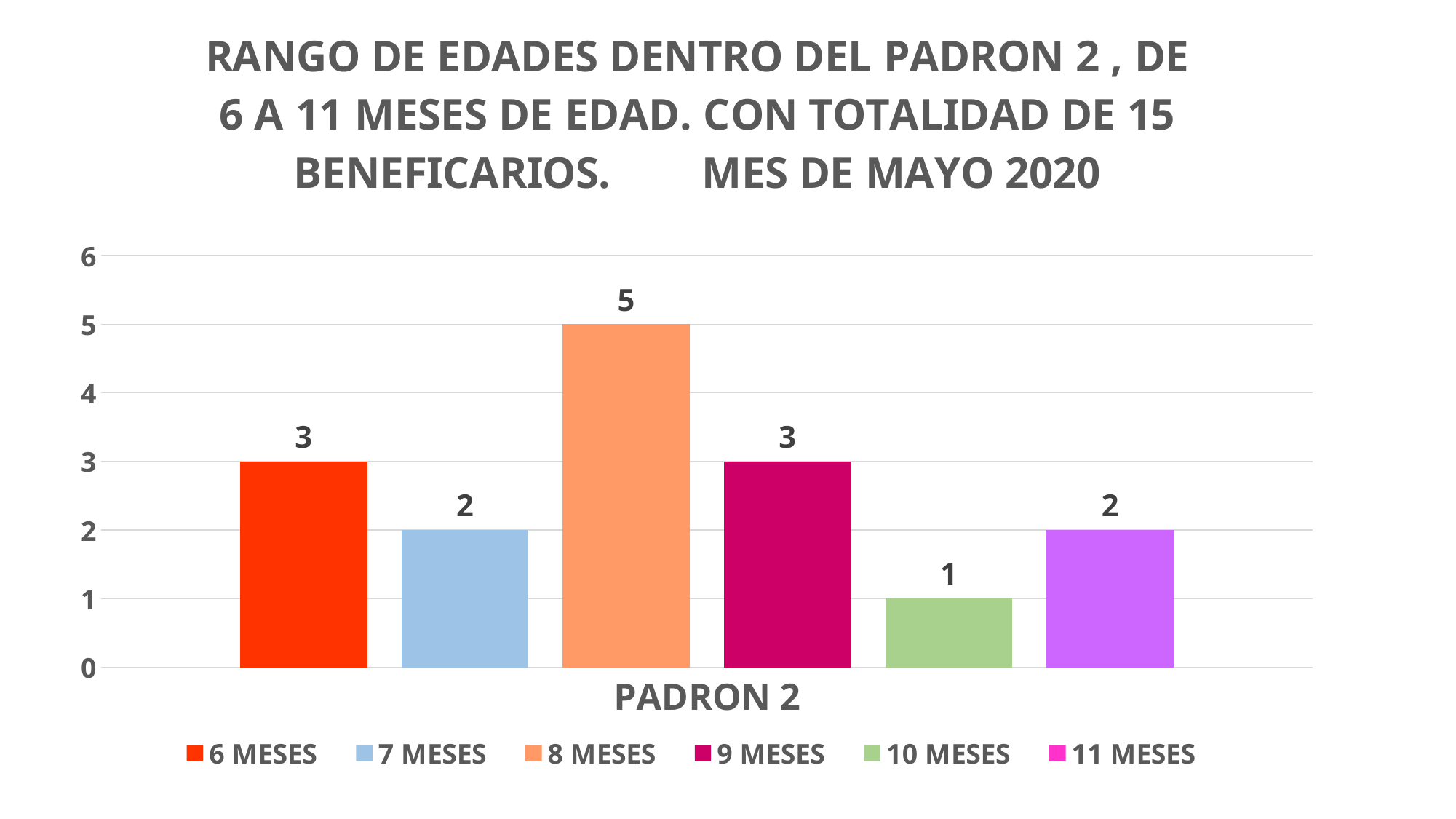
Is the value for 8 MESES greater or less than 4? greater What is the difference between the values for 8 MESES and 7 MESES? 3 What is the category label shown on the x axis? PADRON 2 Which series has the lowest value? 10 MESES What kind of chart is shown? bar chart How many series does the legend list? 6 What is the value for 8 MESES? 5 Which is larger, the value for 9 MESES or the value for 11 MESES? 9 MESES What is the value for 10 MESES? 1 What is the total of all the bar values shown? 15 Which series has the highest value? 8 MESES What is the value for 6 MESES? 3